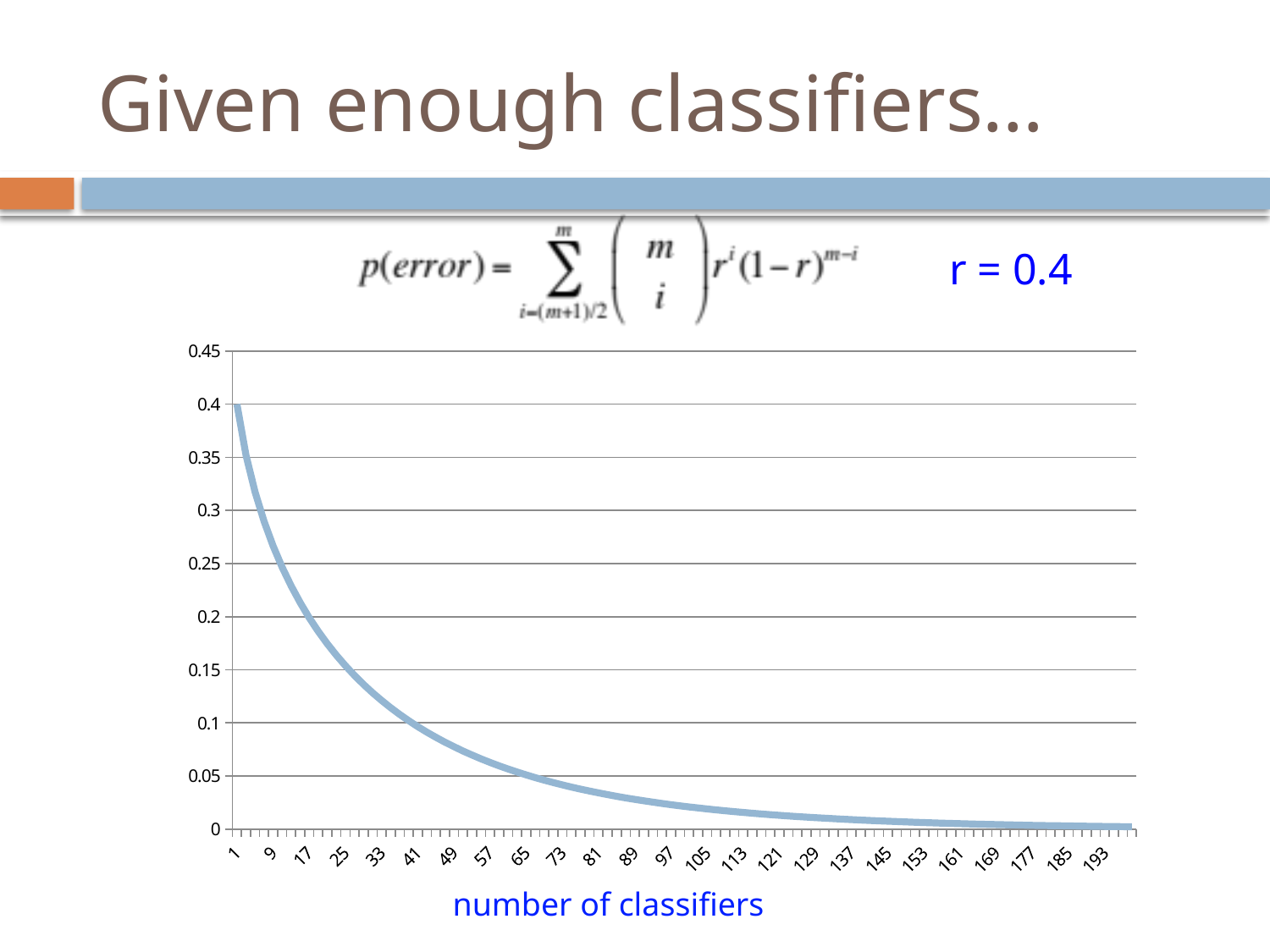
What value of r is stated for the plotted curve? r = 0.4 Which is larger: p(error) at 9 classifiers or at 57 classifiers? 9 classifiers Is the value of p(error) at 33 classifiers greater or less than 0.2? less What is the value of p(error) when the number of classifiers is 1? 0.4 At which labelled number of classifiers is p(error) lowest? 193 What is the label of the x axis? number of classifiers How many tick labels are shown on the x axis? 25 Does p(error) rise or fall as the number of classifiers increases? fall Is the value of p(error) at 97 classifiers greater or less than 0.05? less At which number of classifiers is p(error) highest? 1 Is the value of p(error) at 9 classifiers greater or less than 0.25? greater What kind of chart is shown on the slide? line chart